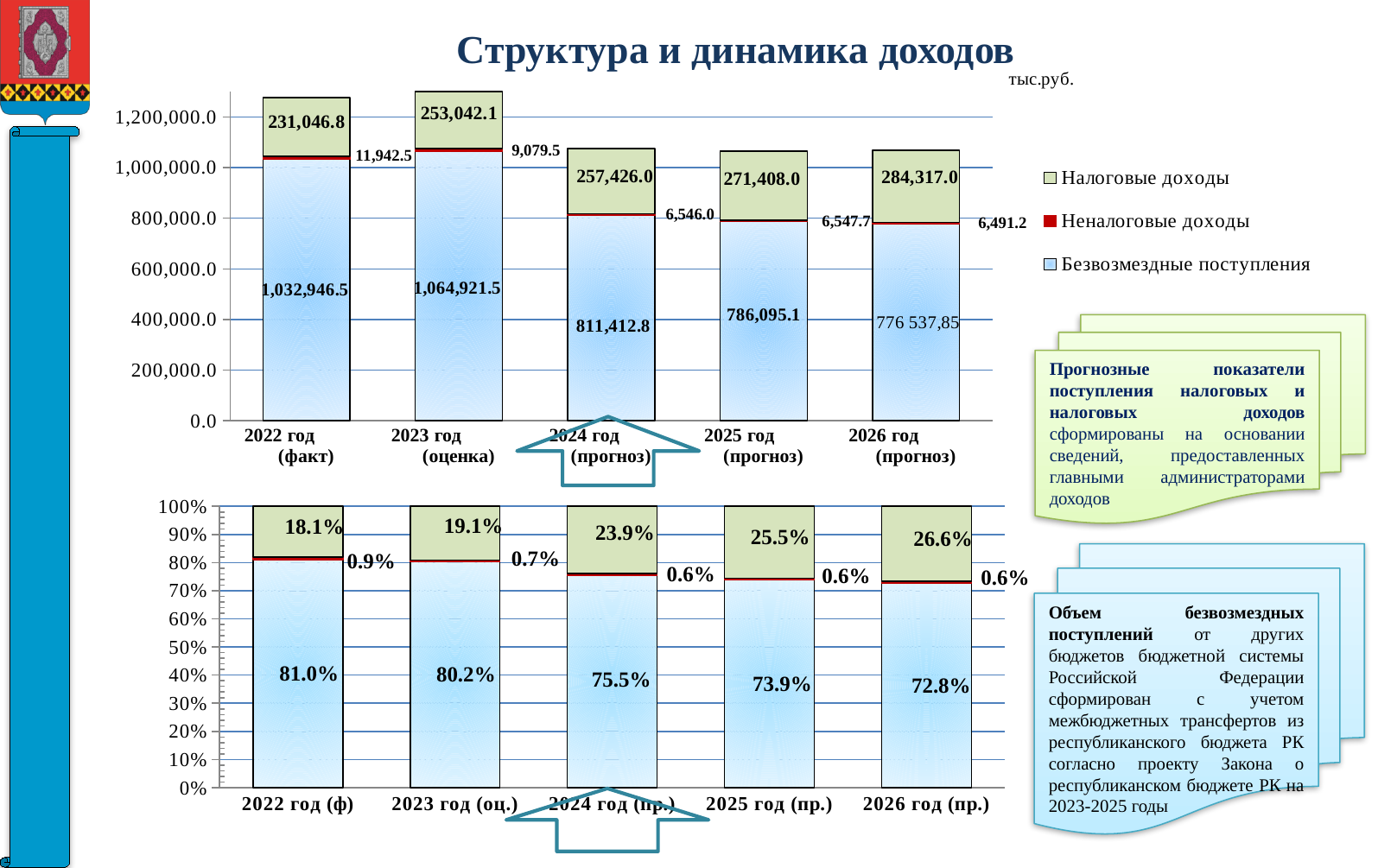
On the bottom chart, does the share of Налоговые доходы rise or fall from 2022 to 2026? rise On the top chart, what is the value of Налоговые доходы for 2022 год (факт)? 231,046.8 On the top chart, what is the value of Безвозмездные поступления for 2024 год (прогноз)? 811,412.8 How many series does the legend list? 3 On the top chart, what is the total of the stacked bar for 2024 год (прогноз)? 1,075,384.8 What type of chart is the top chart? stacked bar chart On the top chart, what is the difference between Налоговые доходы in 2026 год (прогноз) and 2022 год (факт)? 53,270.2 On the bottom chart, what is the share of Неналоговые доходы for 2022 год (ф)? 0.9% On the top chart, what is the value of Неналоговые доходы for 2023 год (оценка)? 9,079.5 On the top chart, which year has the highest value of Налоговые доходы? 2026 год (прогноз) On the top chart, which year has the lowest value of Безвозмездные поступления? 2026 год (прогноз) On the bottom chart, what is the share of Безвозмездные поступления for 2025 год (пр.)? 73.9%